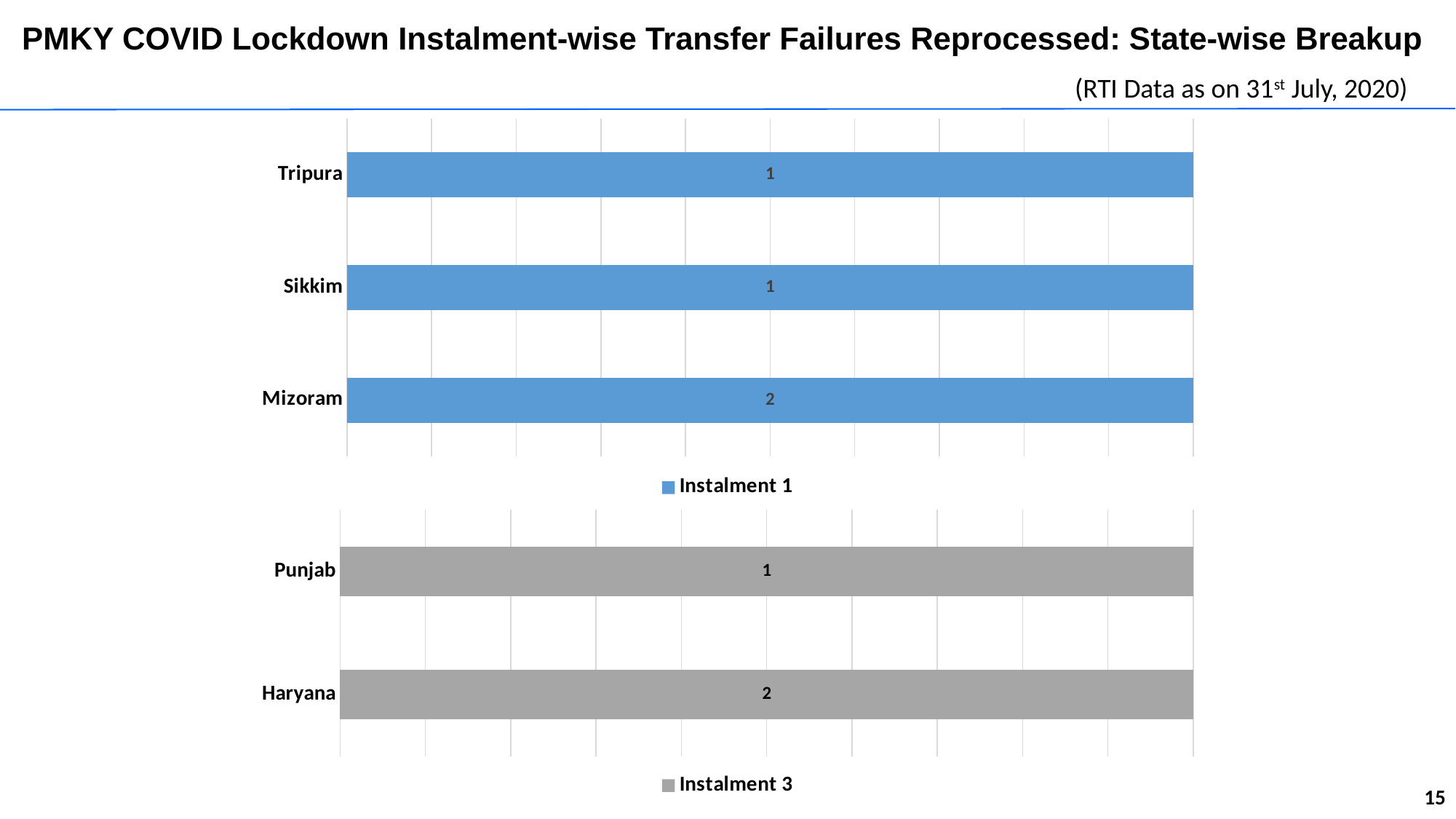
How many states are shown in the top chart (Instalment 1)? 3 In the top chart (Instalment 1), what is the value for Sikkim? 1 In the top chart (Instalment 1), which is larger, the value for Mizoram or the value for Sikkim? Mizoram How many states are shown in the bottom chart (Instalment 3)? 2 In the top chart (Instalment 1), what is the value for Mizoram? 2 What kind of chart is the bottom chart (Instalment 3)? Bar chart In the bottom chart (Instalment 3), what is the value for Haryana? 2 In the top chart (Instalment 1), which state has the highest value? Mizoram In the bottom chart (Instalment 3), what is the difference between the values for Haryana and Punjab? 1 In the bottom chart (Instalment 3), which state has the highest value? Haryana In the bottom chart (Instalment 3), what is the value for Punjab? 1 In the top chart (Instalment 1), what is the value for Tripura? 1